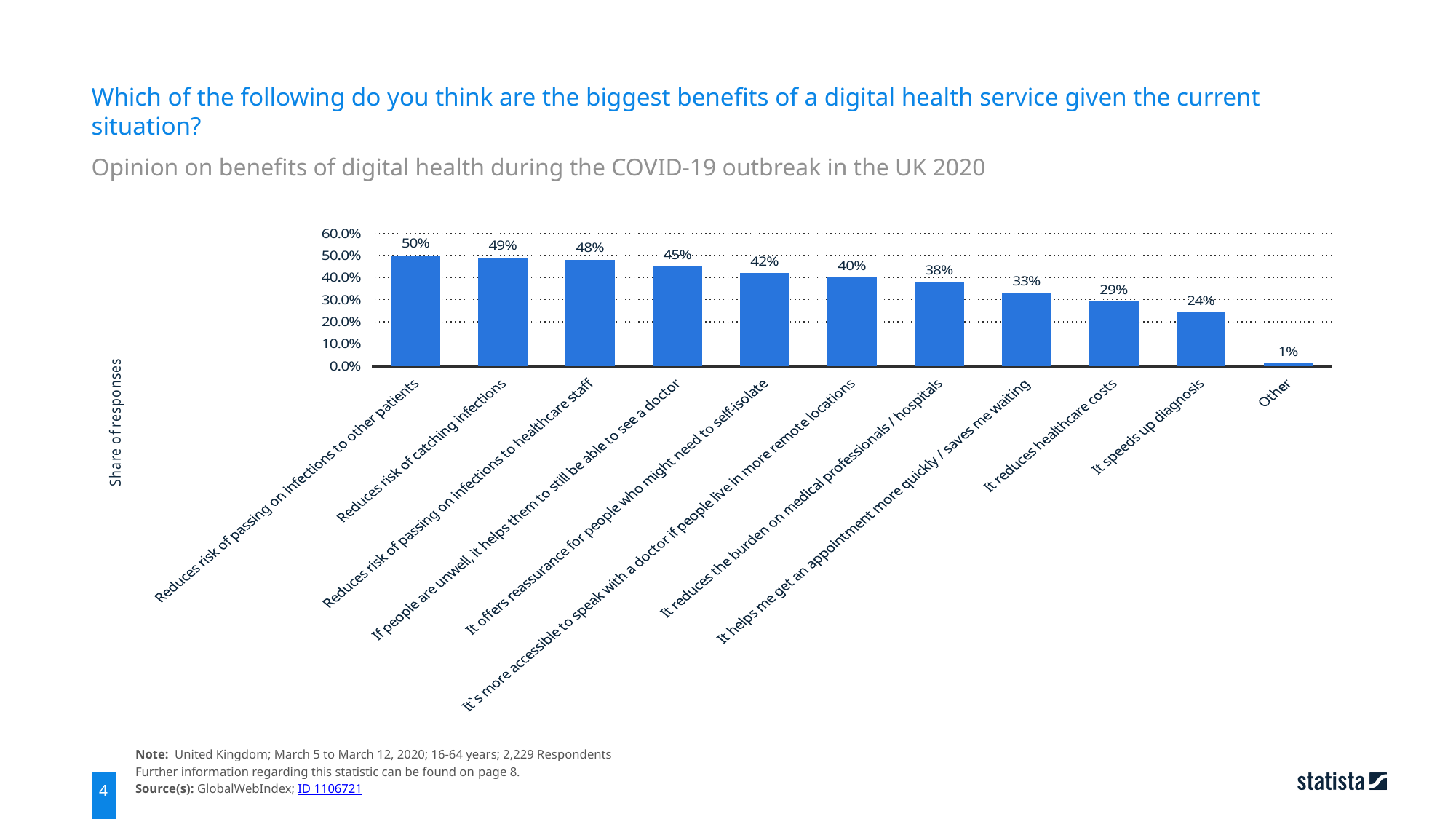
What share of respondents chose 'Reduces risk of catching infections' as a benefit? 49% What is the label of the vertical axis? Share of responses Which is larger: 'It offers reassurance for people who might need to self-isolate' or 'It reduces the burden on medical professionals / hospitals'? It offers reassurance for people who might need to self-isolate What share of responses does 'It reduces healthcare costs' have? 29% What is the value for 'It speeds up diagnosis'? 24% How many categories are shown on the chart? 11 What is the difference between 'Reduces risk of passing on infections to other patients' and 'It speeds up diagnosis'? 26% Which category has the lowest share of responses? Other Do the values rise or fall from left to right along the x axis? Fall Is the value for 'It helps me get an appointment more quickly / saves me waiting' greater or less than 30.0%? greater What kind of chart is shown on the slide? Bar chart Which category has the highest share of responses? Reduces risk of passing on infections to other patients